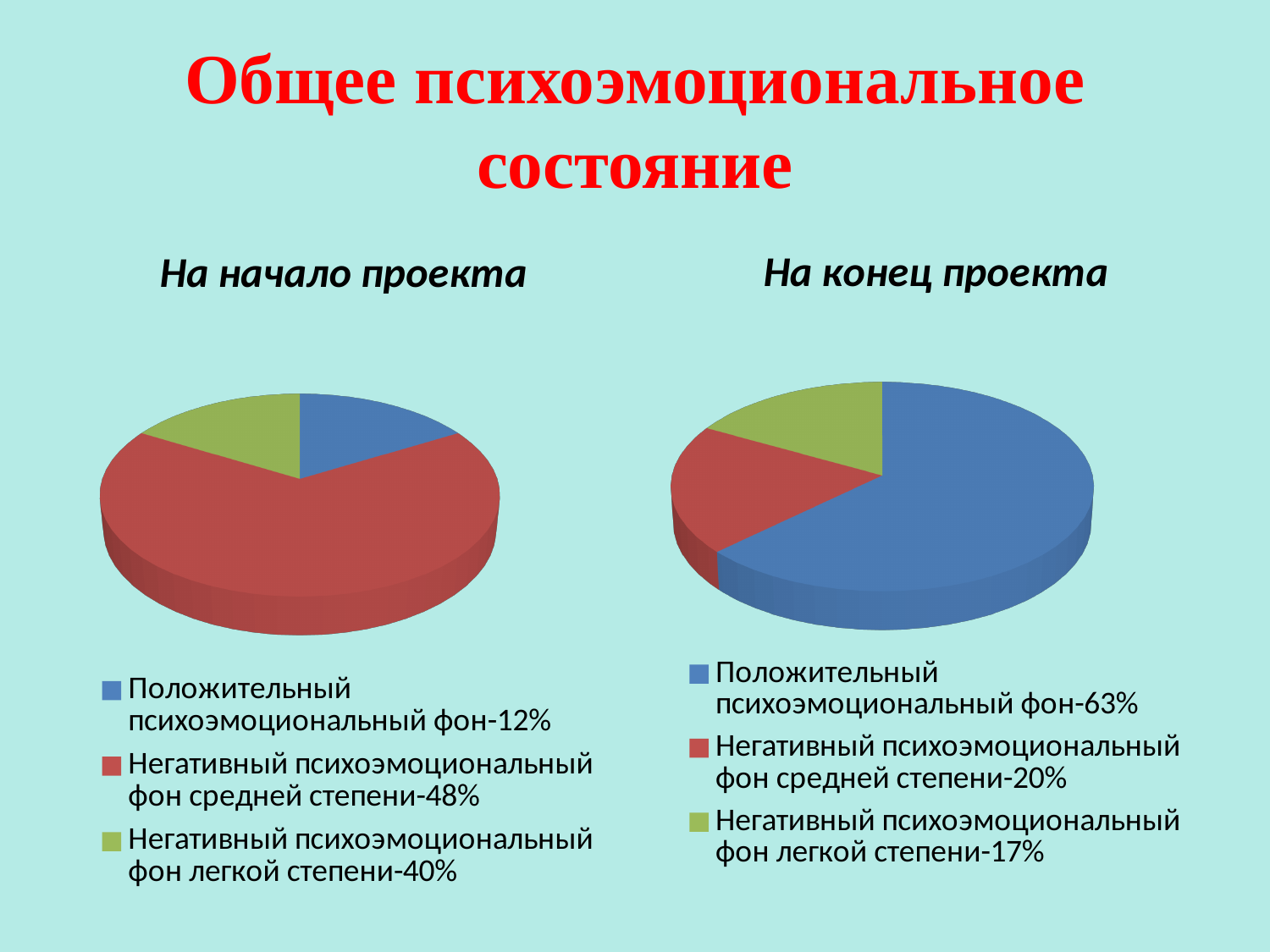
In the "На конец проекта" chart, which category has the smallest share? Негативный психоэмоциональный фон легкой степени In the "На начало проекта" chart, what is the value for "Негативный психоэмоциональный фон средней степени"? 48% What colour represents "Положительный психоэмоциональный фон" in the "На конец проекта" chart? Blue In the "На начало проекта" chart, what is the value for "Положительный психоэмоциональный фон"? 12% How many categories does the "На конец проекта" pie chart have? 3 In the "На начало проекта" chart, which category has the largest share? Негативный психоэмоциональный фон средней степени In the "На конец проекта" chart, what is the value for "Негативный психоэмоциональный фон легкой степени"? 17% In the "На конец проекта" chart, what is the value for "Положительный психоэмоциональный фон"? 63% What type of chart is used on the slide for "На начало проекта"? Pie chart How many entries does the legend of the "На начало проекта" chart list? 3 In the "На конец проекта" chart, what is the difference between "Положительный психоэмоциональный фон" and "Негативный психоэмоциональный фон средней степени"? 43 percentage points Which is larger: "Положительный психоэмоциональный фон" in the "На начало проекта" chart or in the "На конец проекта" chart? На конец проекта